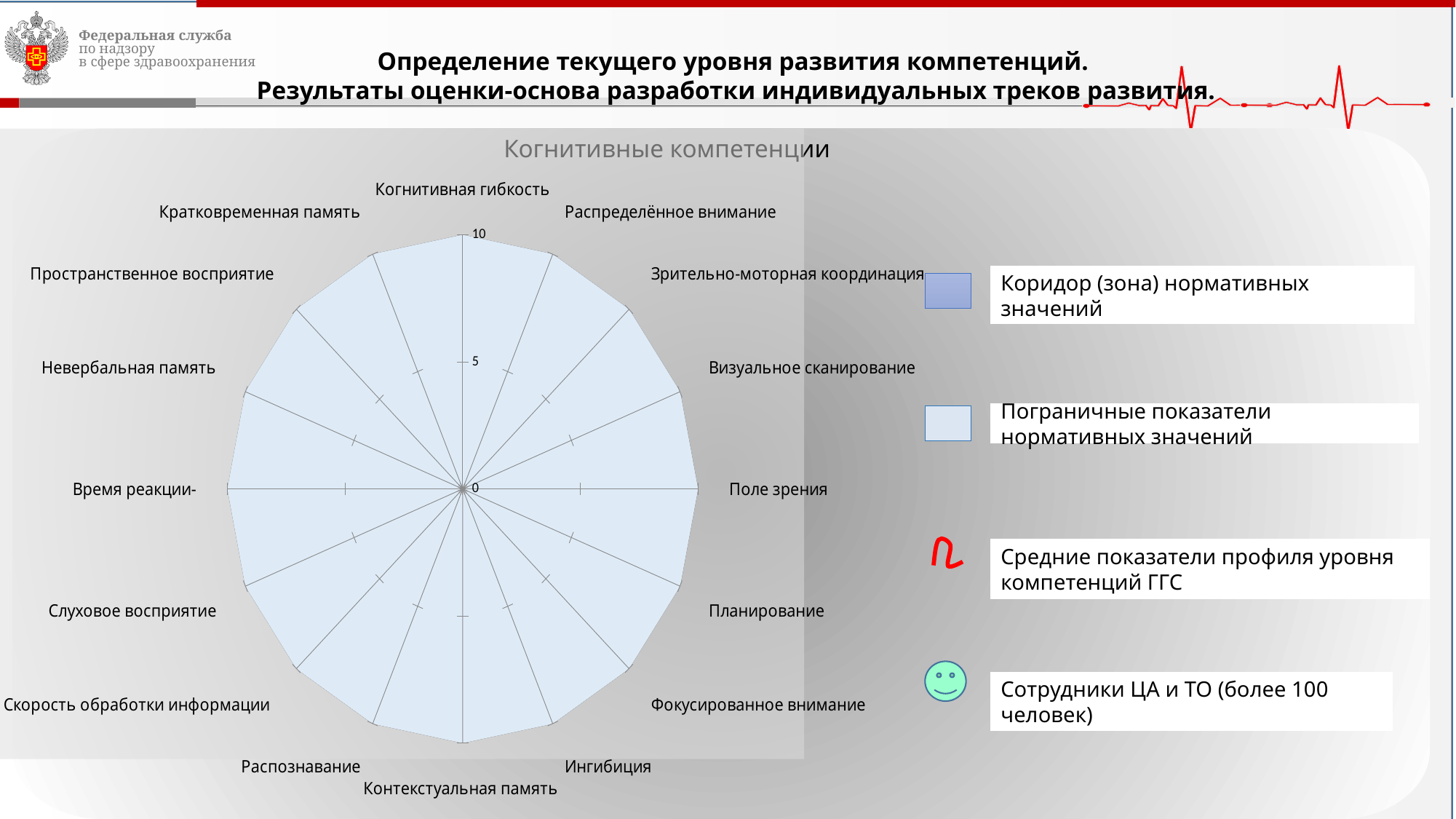
Is the value for Время реакции greater or less than 5? greater How many categories (axes) does the radar chart have? 16 What is the maximum value shown on the radar chart's axis scale? 10 Is the value for Слуховое восприятие greater or less than 5? greater Is the value for Поле зрения greater or less than 5? greater What kind of chart is shown on the slide? Radar chart What is the title of the chart? Когнитивные компетенции